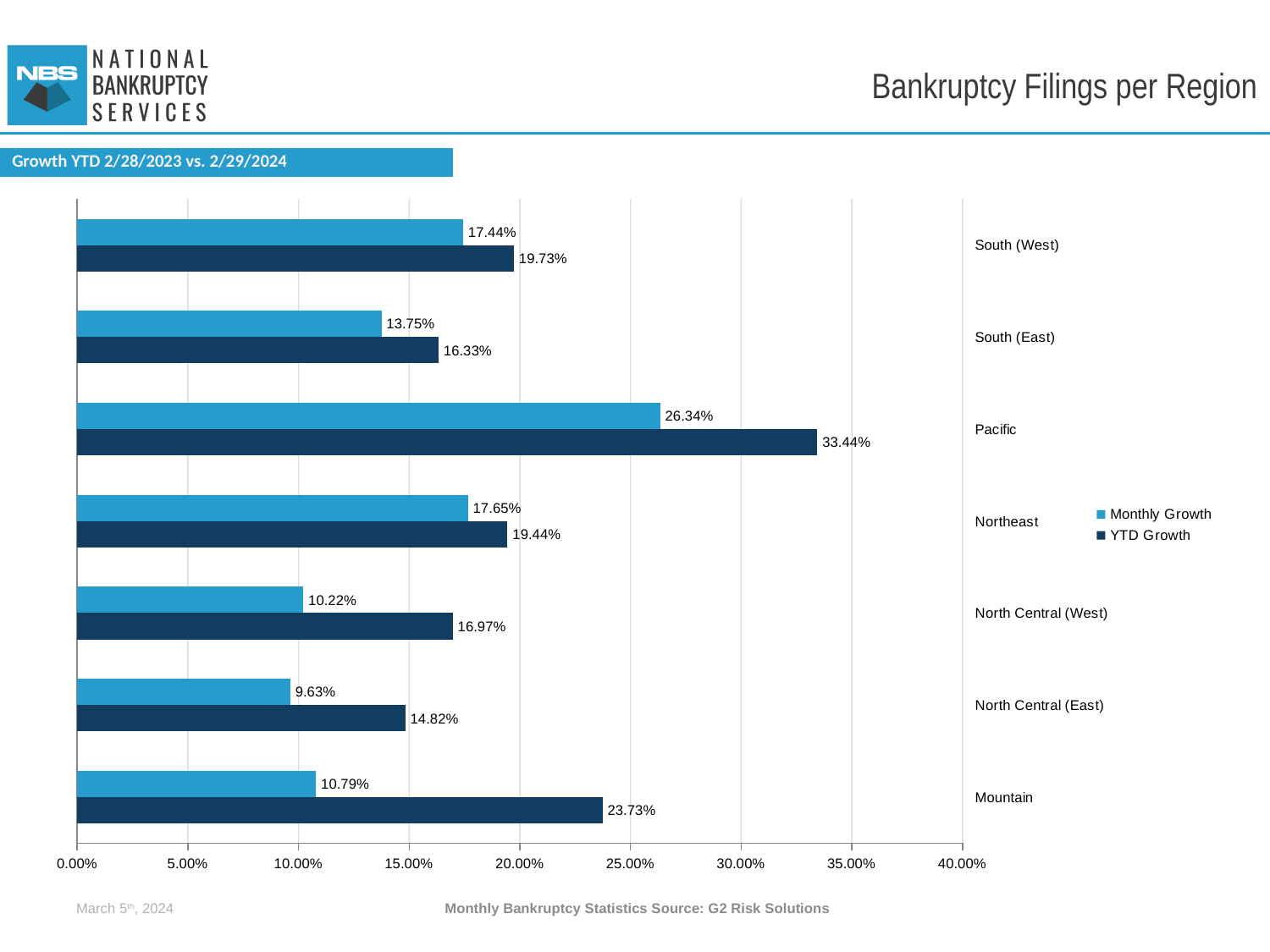
Is the YTD Growth value for Pacific greater or less than 30.00%? greater Which region has the highest Monthly Growth? Pacific Which region has the lowest YTD Growth? North Central (East) What is the title of the chart? Growth YTD 2/28/2023 vs. 2/29/2024 What is the YTD Growth value for Pacific? 33.44% Which is larger, the Monthly Growth for South (West) or the Monthly Growth for South (East)? South (West) What kind of chart is shown on the slide? Bar chart What is the Monthly Growth value for North Central (East)? 9.63% What is the difference between YTD Growth and Monthly Growth for Mountain? 12.94% How many regions are shown on the chart? 7 How many series does the legend list? 2 What is the YTD Growth value for Mountain? 23.73%